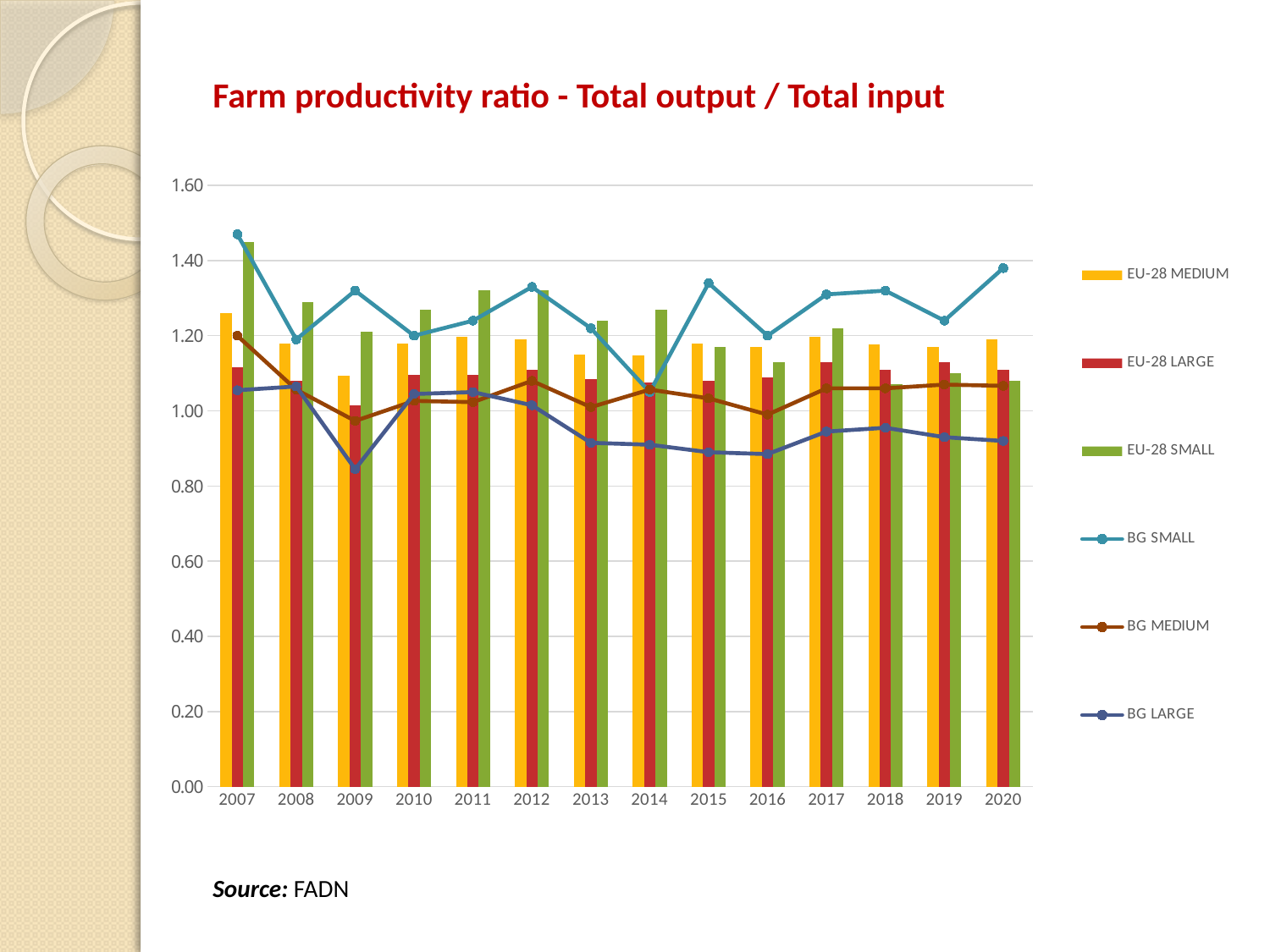
Is the BG SMALL value for 2007 greater or less than 1.40? greater In which year is the EU-28 MEDIUM value lowest? 2009 Is the BG LARGE value for 2009 greater or less than 1.00? less What kind of chart is this? Combined bar and line chart In which year is the BG SMALL value highest? 2007 In which year is the BG LARGE value lowest? 2009 How many years are shown on the x axis? 14 What is the title of the chart? Farm productivity ratio - Total output / Total input Is the BG MEDIUM value for 2009 greater or less than 1.00? less How many series does the legend list? 6 In 2014, which is larger: EU-28 SMALL or EU-28 MEDIUM? EU-28 SMALL Does the BG LARGE line rise or fall overall from 2007 to 2020? fall